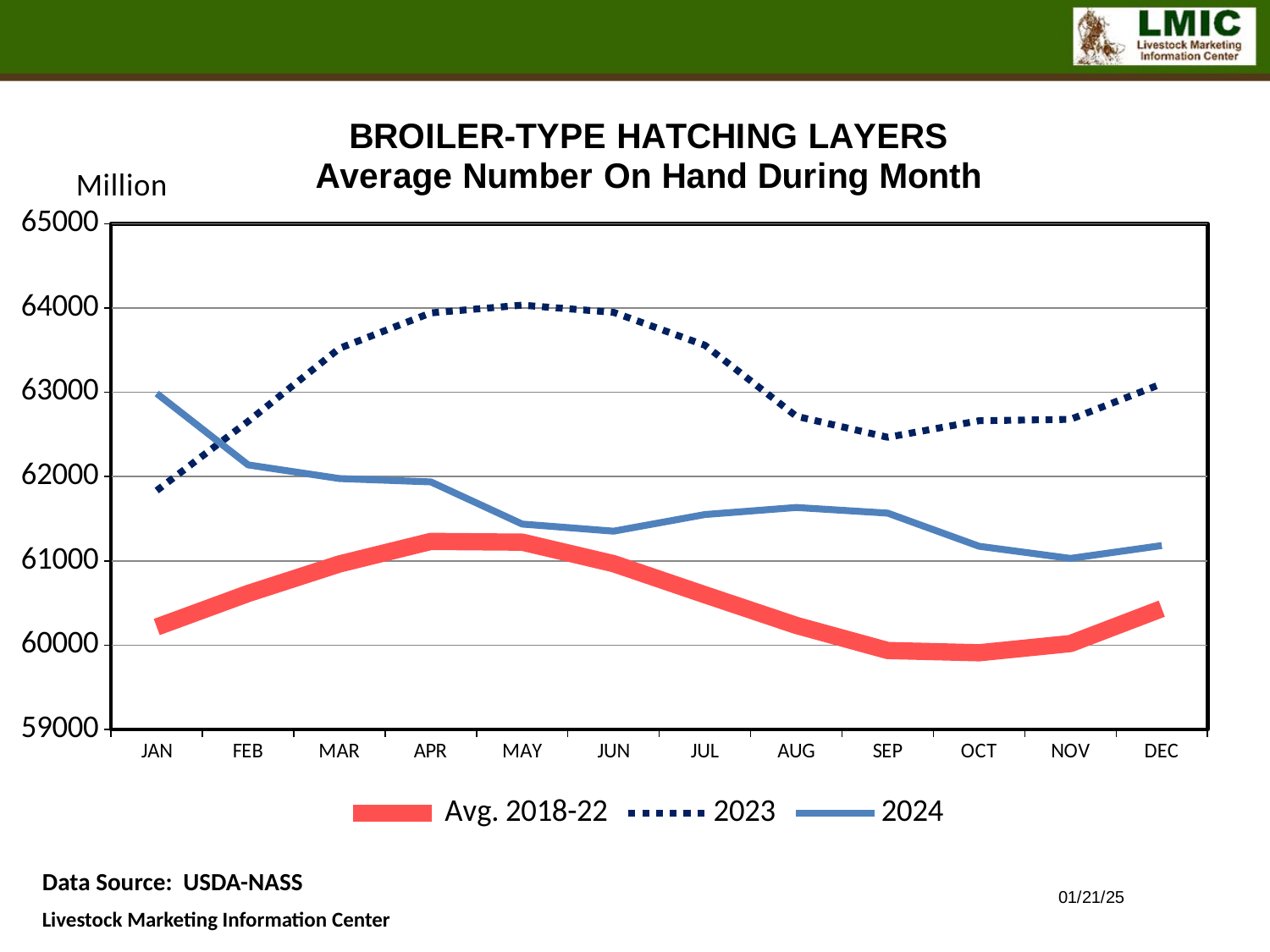
Does the 2024 series rise or fall from JAN to MAY? fall Is the Avg. 2018-22 value for JAN greater or less than 60000? greater How many months are plotted along the x axis? 12 How many series does the legend list? 3 In which month does the 2023 series reach its lowest value? SEP What kind of chart is shown on the slide? line chart What unit label is shown above the y axis? Million In JAN, which series has the larger value, 2023 or 2024? 2024 Is the 2024 value for JAN greater or less than 62000? greater In JUN, which series has the larger value, 2023 or 2024? 2023 In which month does the 2024 series reach its highest value? JAN Is the 2023 value for JAN greater or less than 62000? less